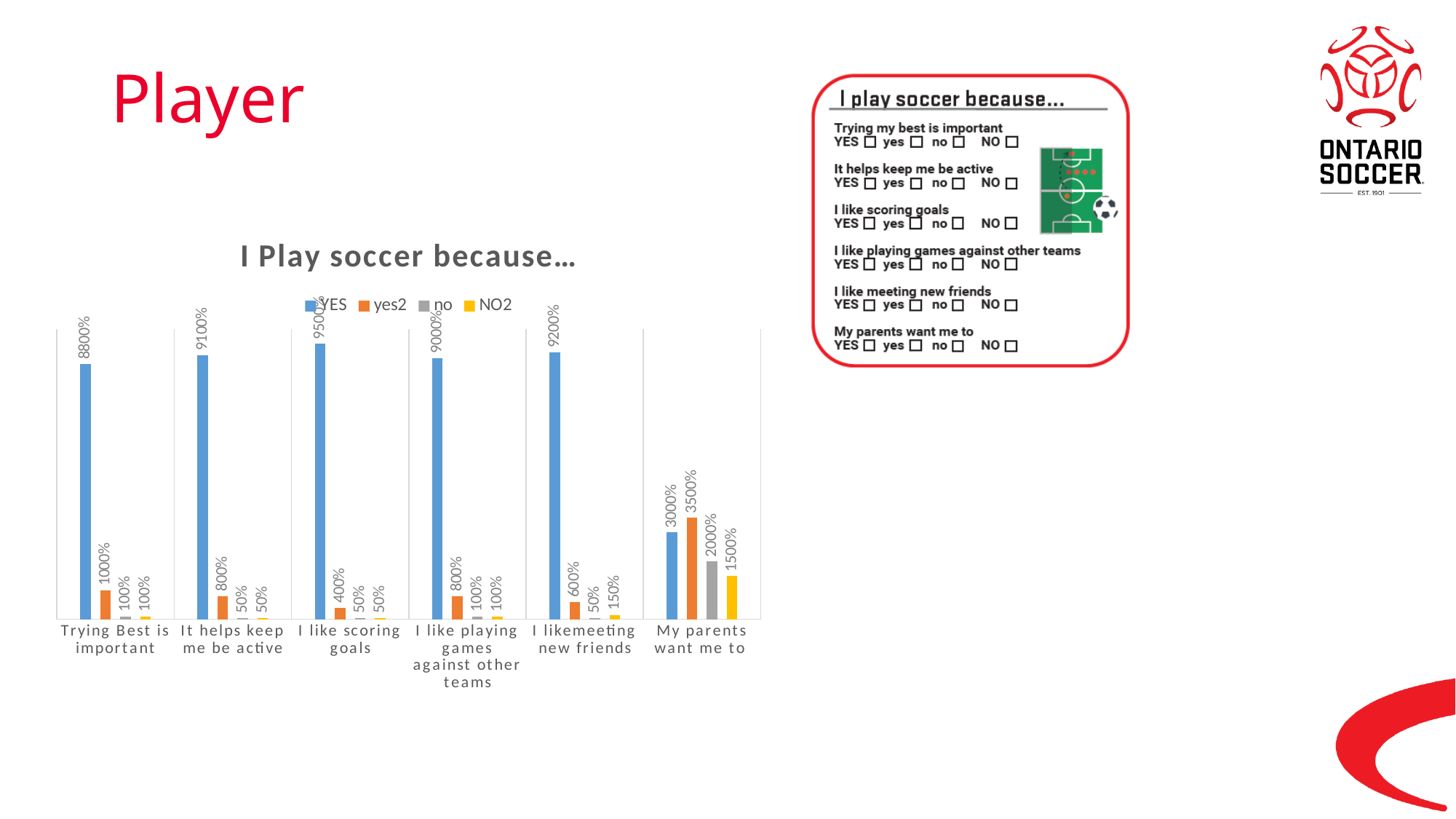
What is the YES value for 'I like scoring goals'? 9500% For 'My parents want me to', which is larger: the YES value or the yes2 value? yes2 What is the difference between the YES value for 'I like scoring goals' and the YES value for 'Trying Best is important'? 700% What kind of chart is shown on the slide? bar chart What is the NO2 value for 'I like meeting new friends'? 150% Which category has the lowest YES value? My parents want me to What is the 'no' value for 'It helps keep me be active'? 50% What is the chart title? I Play soccer because… Which category has the highest YES value? I like scoring goals How many series does the legend list? 4 What is the yes2 value for 'My parents want me to'? 3500% How many categories are shown on the x axis? 6